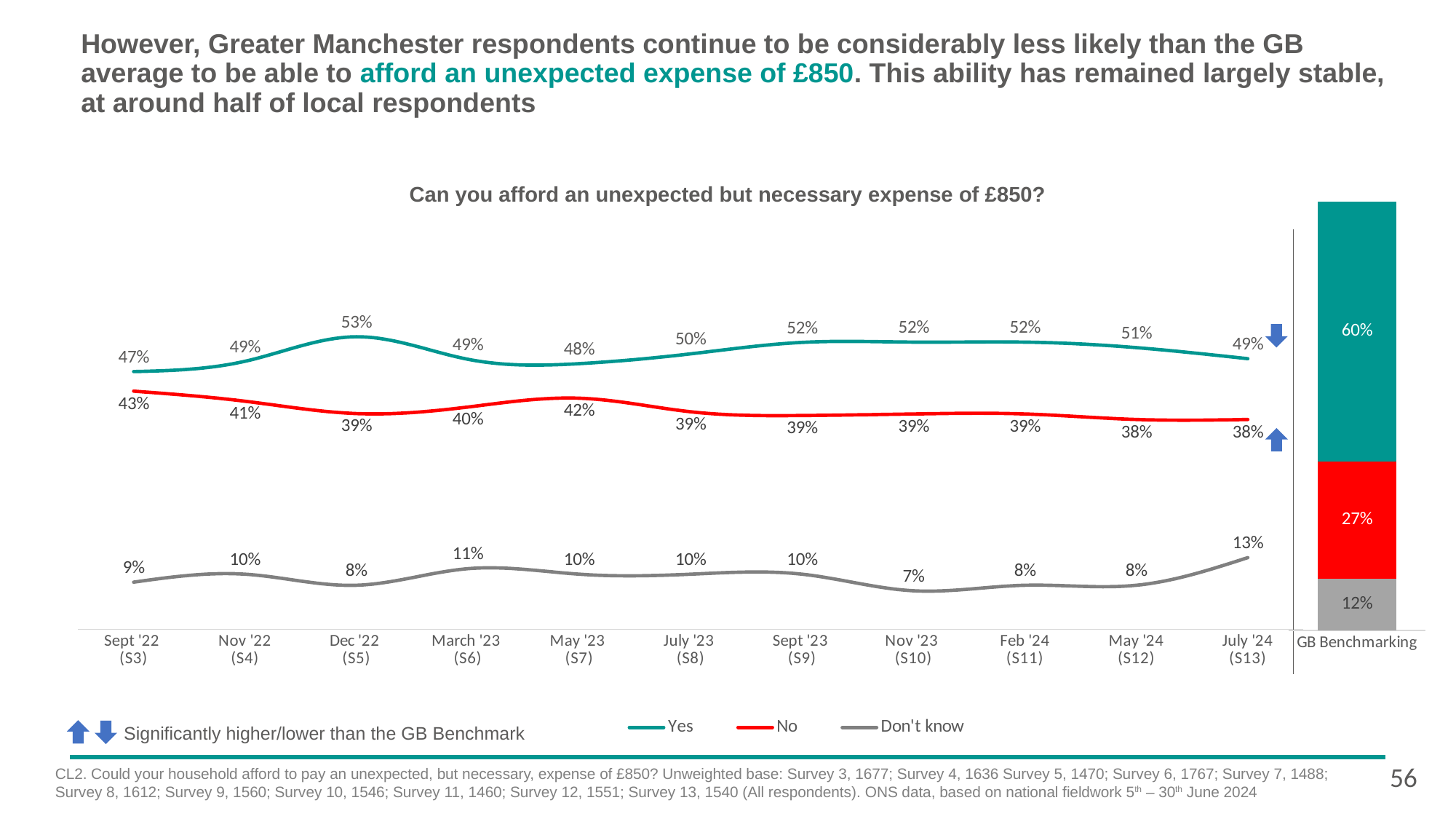
In which survey wave was the Yes value highest? Dec '22 (S5) How many series does the legend list? 3 What is the No value for July '24 (S13)? 38% Which is larger: the Yes value in Sept '22 (S3) or the Yes value in Sept '23 (S9)? Sept '23 (S9) In which survey wave was the Don't know value lowest? Nov '23 (S10) How many survey waves are plotted on the line chart (excluding GB Benchmarking)? 11 What is the Yes share in the GB Benchmarking bar? 60% What is the total of the GB Benchmarking stacked bar? 99% What is the difference between the GB Benchmarking Yes value and the July '24 (S13) Yes value? 11 percentage points What percentage of respondents answered Yes in Dec '22 (S5)? 53% What is the Don't know value for Nov '23 (S10)? 7% In which survey wave was the No value highest? Sept '22 (S3)